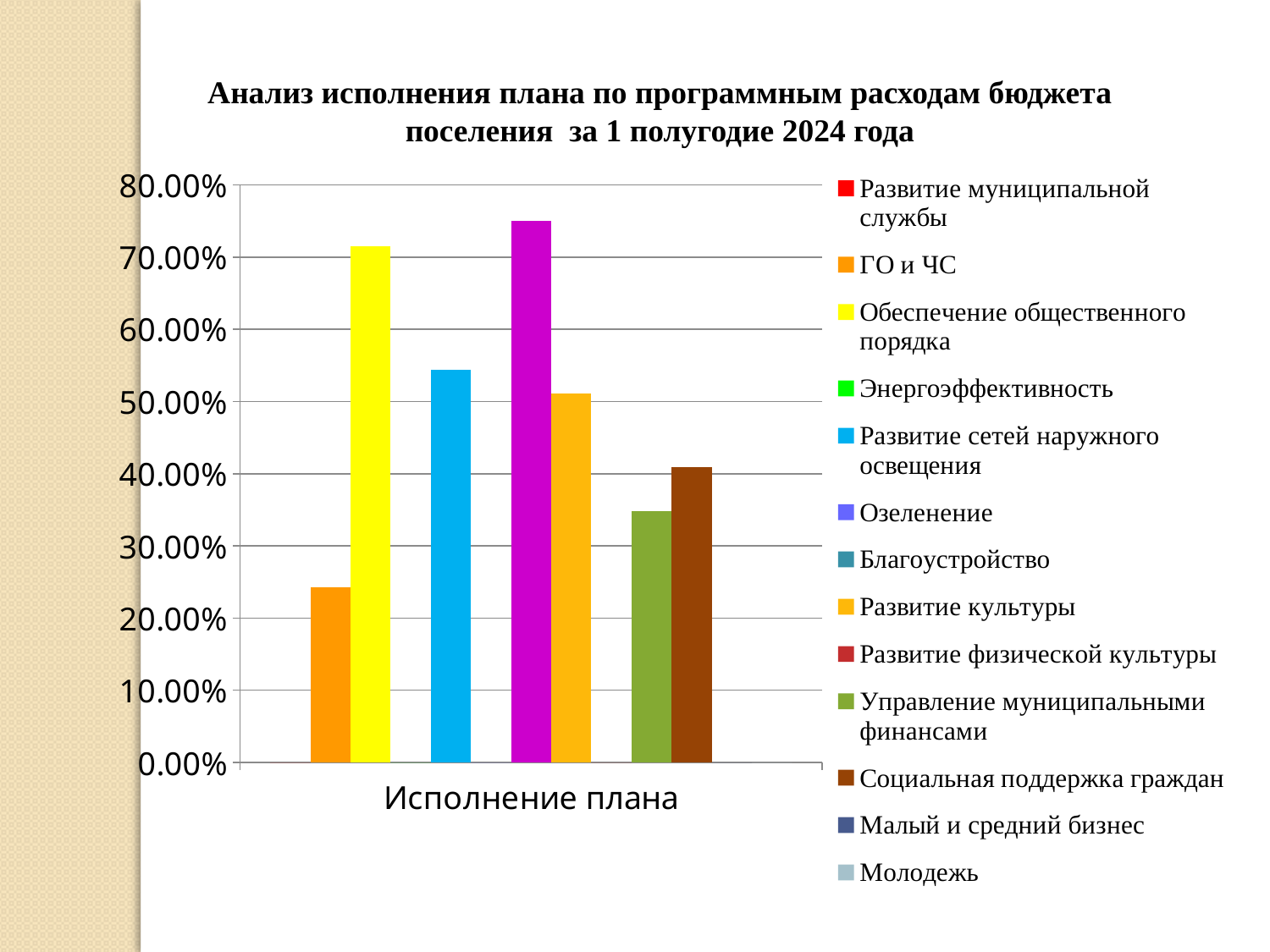
Is the value for Обеспечение общественного порядка greater or less than 60.00%? greater What kind of chart is shown on the slide? bar chart Which is larger, the value for Развитие культуры or the value for Социальная поддержка граждан? Развитие культуры How many categories are shown on the x axis? 1 What is the title of the chart? Анализ исполнения плана по программным расходам бюджета поселения за 1 полугодие 2024 года Is the value for Управление муниципальными финансами greater or less than 40.00%? less What is the label of the single category on the x axis? Исполнение плана Is the value for Социальная поддержка граждан greater or less than 50.00%? less Which is larger, the value for Обеспечение общественного порядка or the value for ГО и ЧС? Обеспечение общественного порядка How many series does the legend list? 13